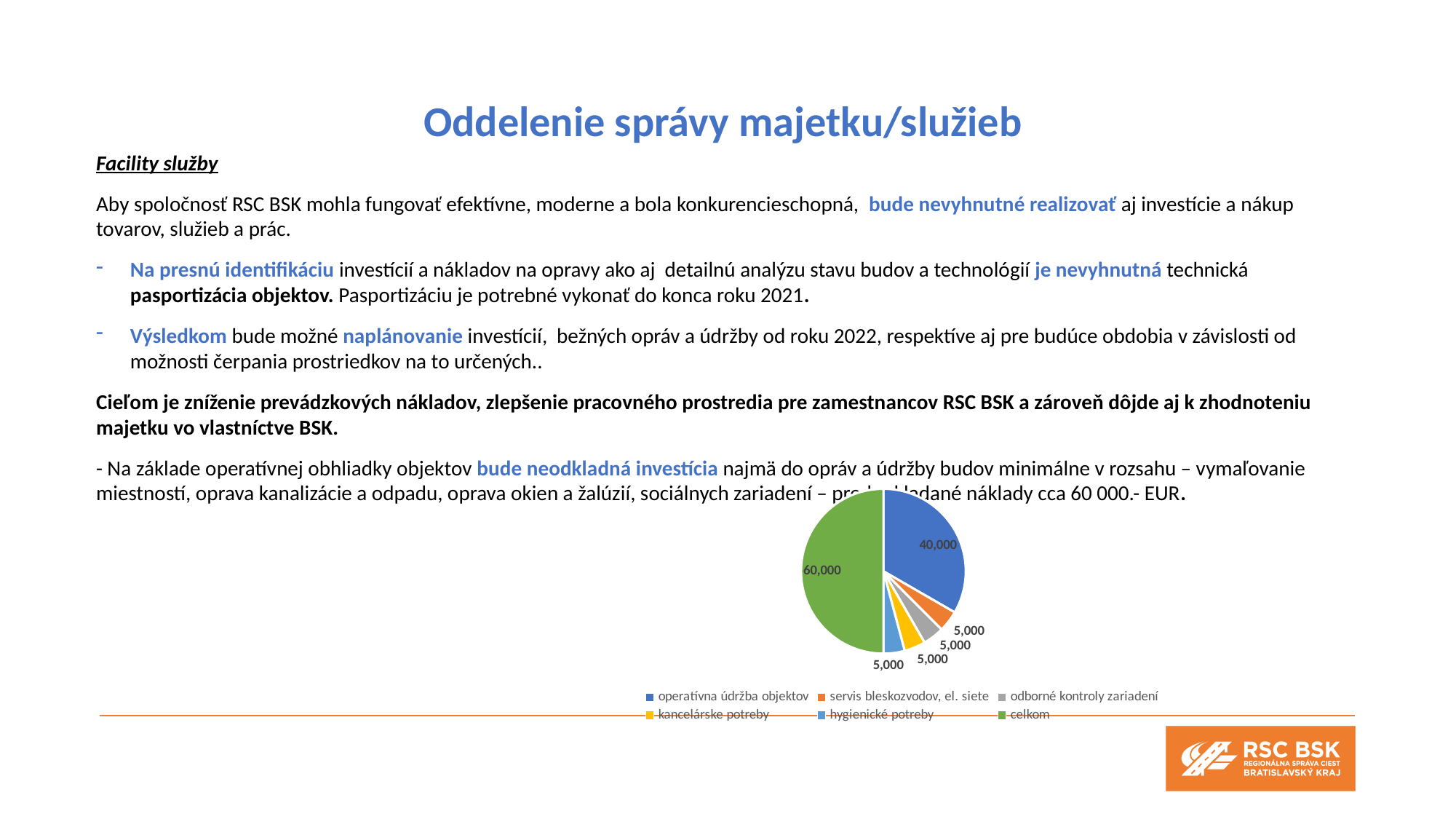
What is the value for celkom in the pie chart? 60,000 How many slices does the pie chart have? 6 What is the value for servis bleskozvodov, el. siete in the pie chart? 5,000 What is the difference between the values for celkom and operatívna údržba objektov? 20,000 What kind of chart is shown on the slide? pie chart What share of the whole pie does the celkom slice represent? 50% What colour is the celkom slice in the pie chart? green What is the value for kancelárske potreby in the pie chart? 5,000 How many entries does the legend of the pie chart list? 6 Which is larger: the value for operatívna údržba objektov or the value for hygienické potreby? operatívna údržba objektov Which category has the largest slice in the pie chart? celkom What is the value for operatívna údržba objektov in the pie chart? 40,000